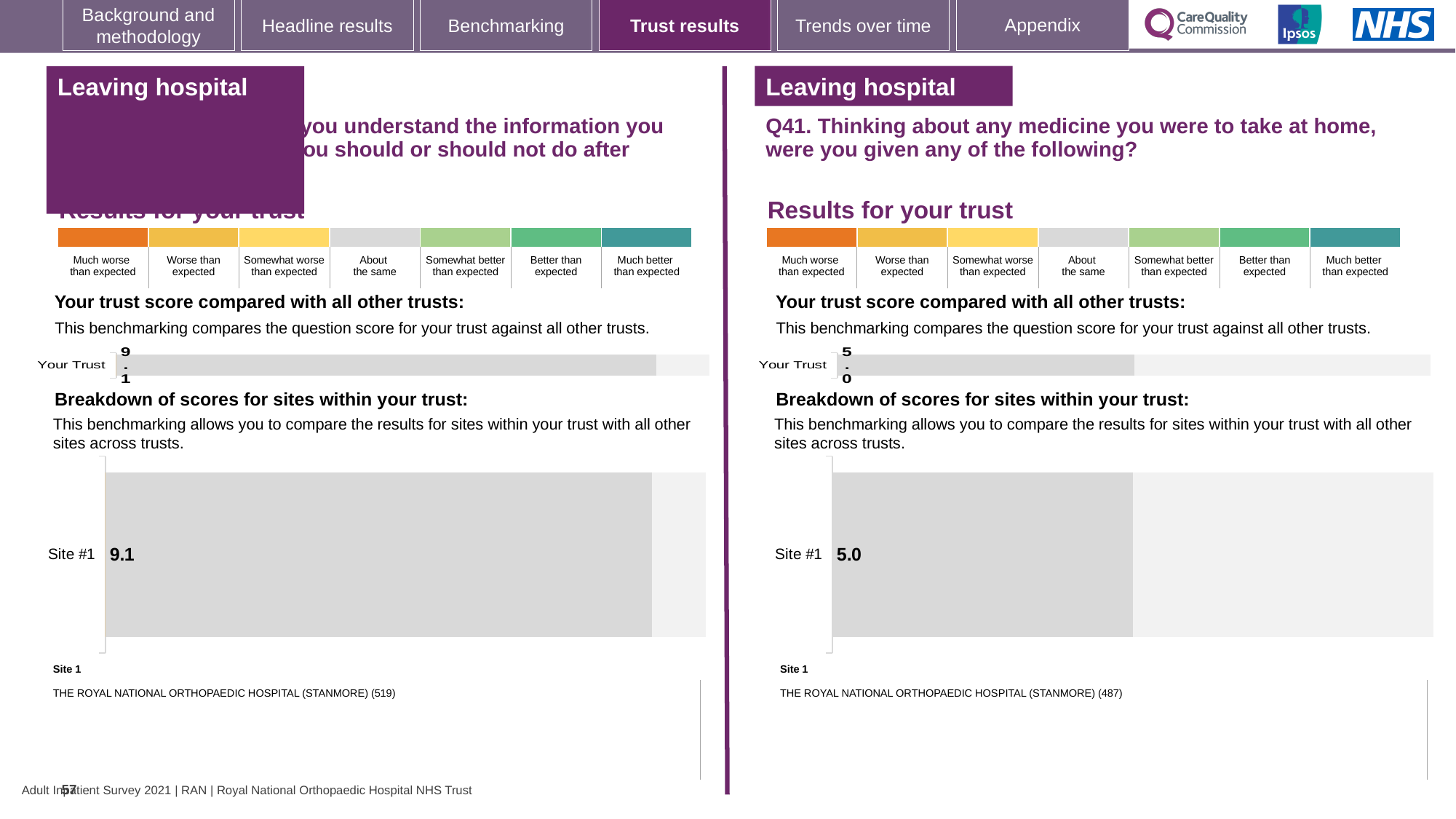
On the right-hand (Q41) breakdown chart, which site is labelled as Site 1? THE ROYAL NATIONAL ORTHOPAEDIC HOSPITAL (STANMORE) (487) On the left-hand 'Breakdown of scores for sites within your trust' chart, what is the score for Site #1? 9.1 On the right-hand (Q41) 'Breakdown of scores for sites within your trust' chart, what is the score for Site #1? 5.0 What type of chart is used for the 'Breakdown of scores for sites within your trust' on the right-hand (Q41) side? Bar chart On the left-hand breakdown chart, which site is labelled as Site 1? THE ROYAL NATIONAL ORTHOPAEDIC HOSPITAL (STANMORE) (519) How many sites are shown on the right-hand (Q41) 'Breakdown of scores for sites within your trust' chart? 1 On the left-hand 'Your trust score compared with all other trusts' chart, what is the value shown for Your Trust? 9.1 Which is larger: the Site #1 score on the left-hand breakdown chart or the Site #1 score on the right-hand (Q41) breakdown chart? Left-hand chart (9.1) How many sites are shown on the left-hand 'Breakdown of scores for sites within your trust' chart? 1 What is the difference between the Site #1 score on the left-hand breakdown chart (9.1) and the Site #1 score on the right-hand (Q41) breakdown chart (5.0)? 4.1 Is the Site #1 score on the left-hand breakdown chart greater or less than the Site #1 score on the right-hand (Q41) breakdown chart? greater On the right-hand (Q41) 'Your trust score compared with all other trusts' chart, what is the value shown for Your Trust? 5.0